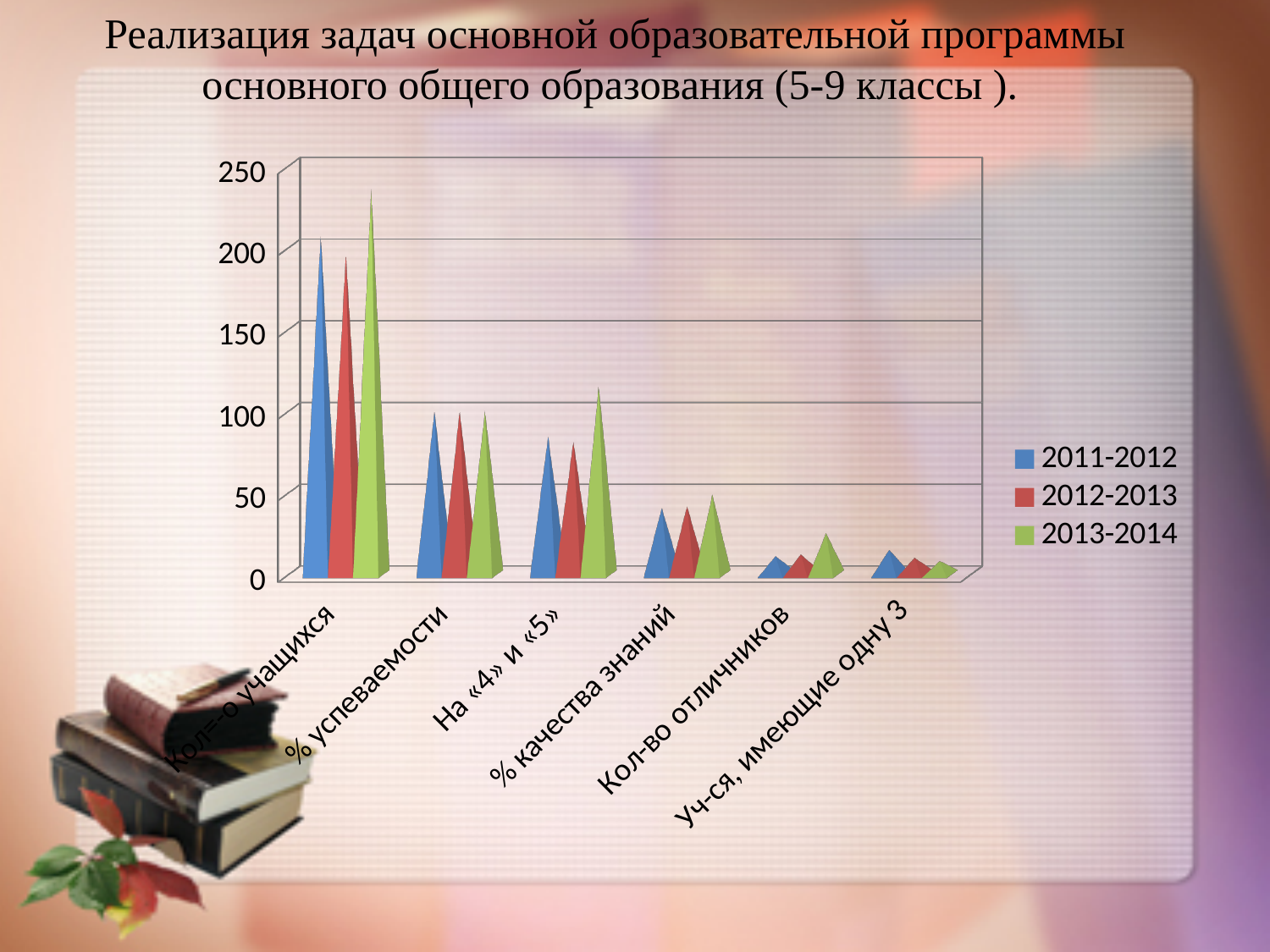
How many categories are shown along the x axis? 6 Is the value for Кол-во отличников in 2013-2014 greater or less than 50? less What kind of chart is shown on the slide? bar chart Which series does the legend list first? 2011-2012 For the category Уч-ся, имеющие одну 3, do the values rise or fall from 2011-2012 to 2013-2014? fall For the category На «4» и «5», which is larger: the value for 2011-2012 or for 2013-2014? 2013-2014 Which category has the highest values across all three series? Кол-во учащихся How many series does the legend list? 3 For the category Кол-во учащихся, which series has the highest value? 2013-2014 Is the value for На «4» и «5» in 2013-2014 greater or less than 100? greater Is the value for % качества знаний in 2011-2012 greater or less than 50? less